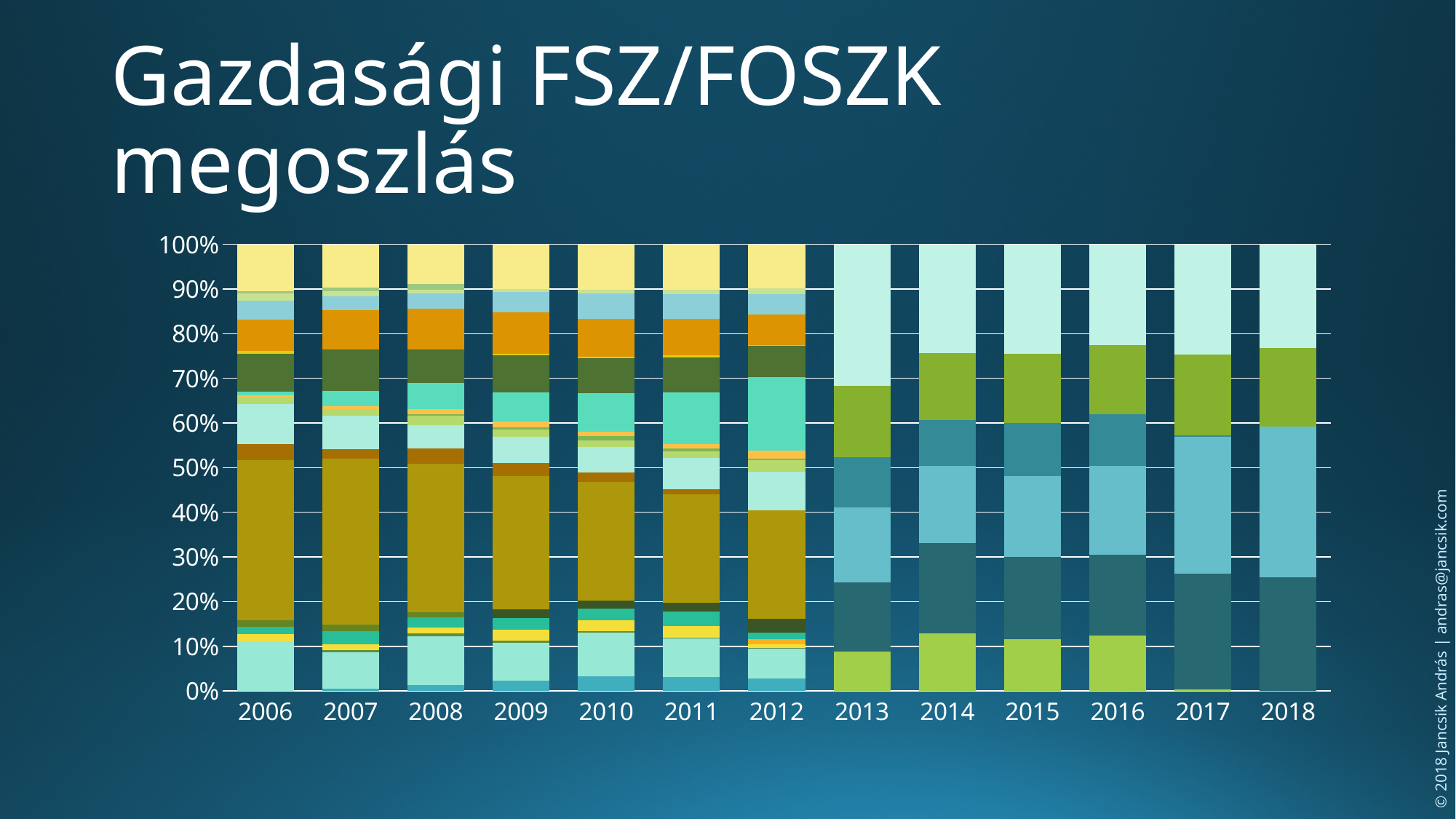
Is the bottom light-green segment of the 2017 bar greater or less than 10%? less What is the last year shown on the x axis? 2018 Is the bottom light-green segment of the 2014 bar greater or less than 10%? greater How many years are shown along the x axis of the chart? 13 What is the first year shown on the x axis? 2006 In the 2006 bar, does the top of the large olive-brown segment lie above or below 50%? above What kind of chart is shown on the slide? Stacked bar chart What is the title of the chart slide? Gazdasági FSZ/FOSZK megoszlás What is the highest value shown on the y axis? 100% What is the total height of the stacked bar for 2010? 100%